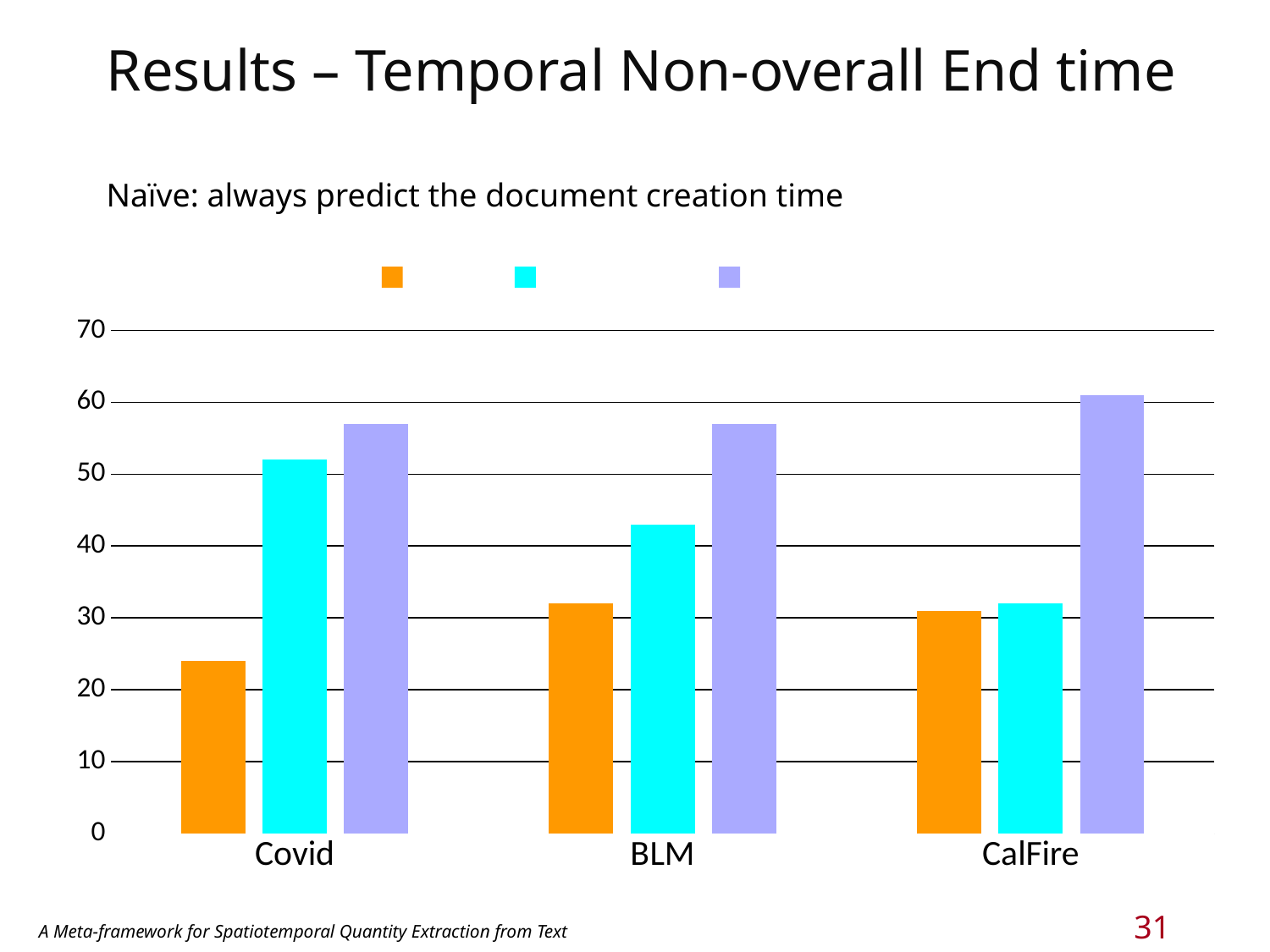
Is the value of the cyan bar for CalFire greater or less than 40? less What kind of chart is shown on the slide? bar chart For which category is the orange bar the lowest? Covid Is the value of the purple bar for Covid greater or less than 50? greater Is the value of the cyan bar for BLM greater or less than 40? greater For which category is the purple bar the highest? CalFire Which category's x-axis label appears first on the left of the chart? Covid How many categories are shown on the x axis of the chart? 3 Which is larger, the cyan bar for Covid or the cyan bar for BLM? Covid How many series does the chart's legend list? 3